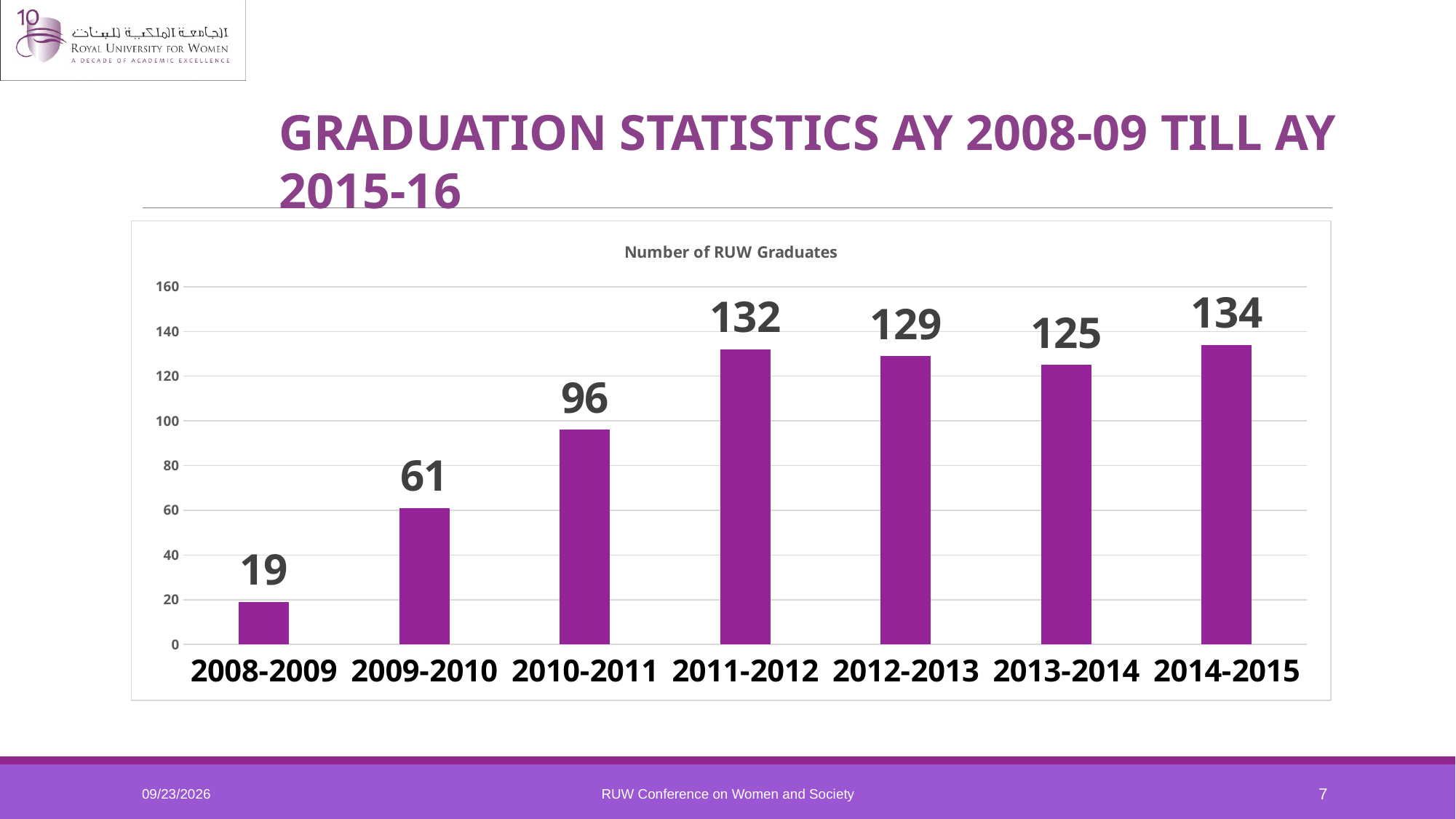
What is the title of the chart? Number of RUW Graduates What is the number of RUW graduates for 2013-2014? 125 What kind of chart is shown on the slide? bar chart How many academic years are shown on the x axis of the chart? 7 Which academic year has the highest number of RUW graduates? 2014-2015 What is the number of RUW graduates for 2011-2012? 132 Which year had more graduates, 2011-2012 or 2012-2013? 2011-2012 What is the difference in the number of graduates between 2014-2015 and 2013-2014? 9 Is the number of graduates for 2010-2011 greater or less than 100? less Which academic year has the lowest number of RUW graduates? 2008-2009 What is the number of RUW graduates for 2008-2009? 19 What is the difference in the number of graduates between 2010-2011 and 2009-2010? 35